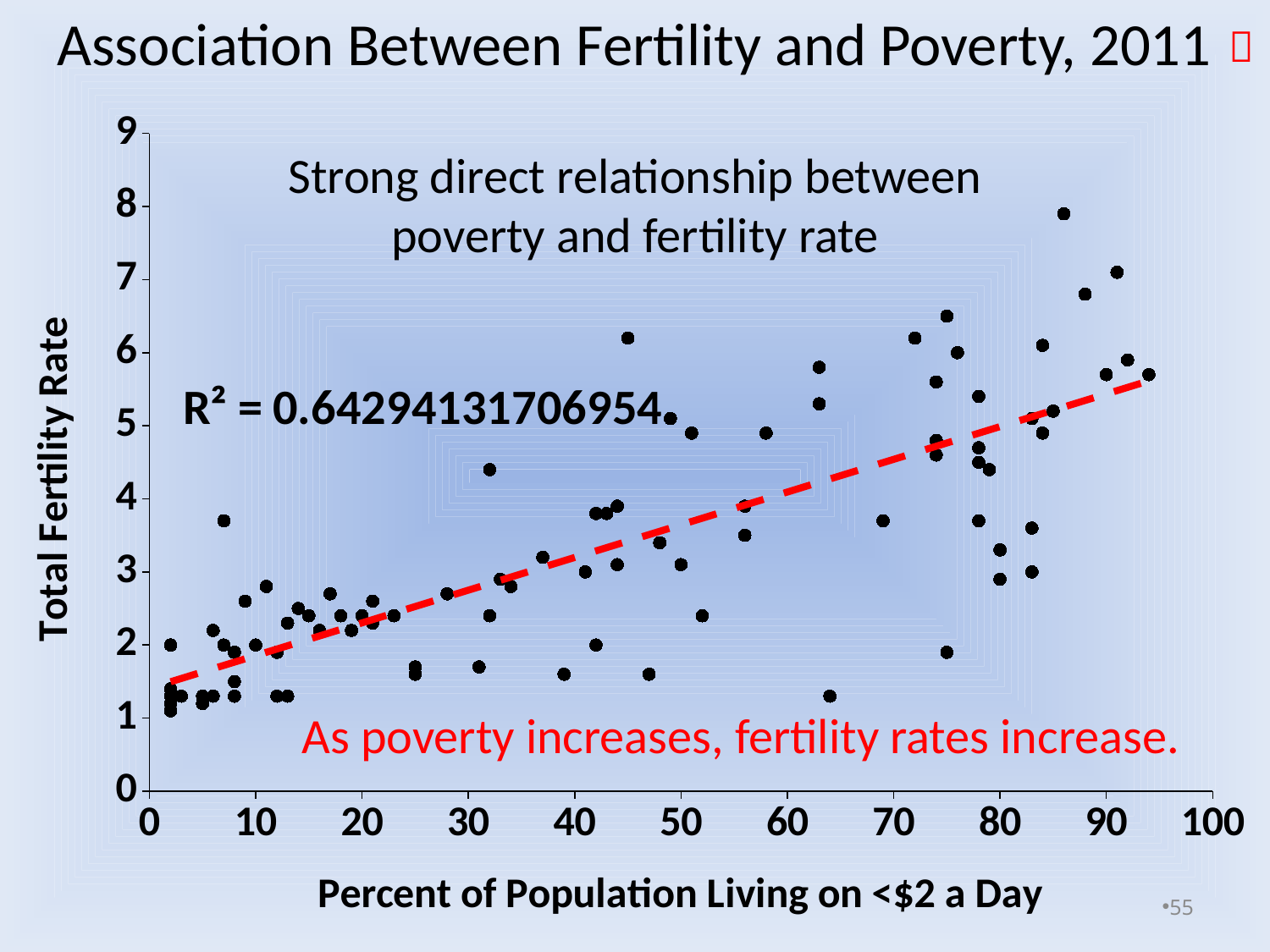
What R² value is printed on the chart? 0.64294131706954 Does the dashed trend line slope upward or downward from left to right? upward Is the lowest total fertility rate plotted on the chart greater or less than 2? less At 90 on the x axis, is the dashed trend line above or below a fertility rate of 5? above What kind of chart is shown on the slide? scatter plot What is the title of the chart? Association Between Fertility and Poverty, 2011 At 0 on the x axis, is the dashed trend line above or below a fertility rate of 2? below As the percent of population living on less than $2 a day increases along the x axis, does the total fertility rate tend to rise or fall? rise What is the label of the x axis? Percent of Population Living on <$2 a Day